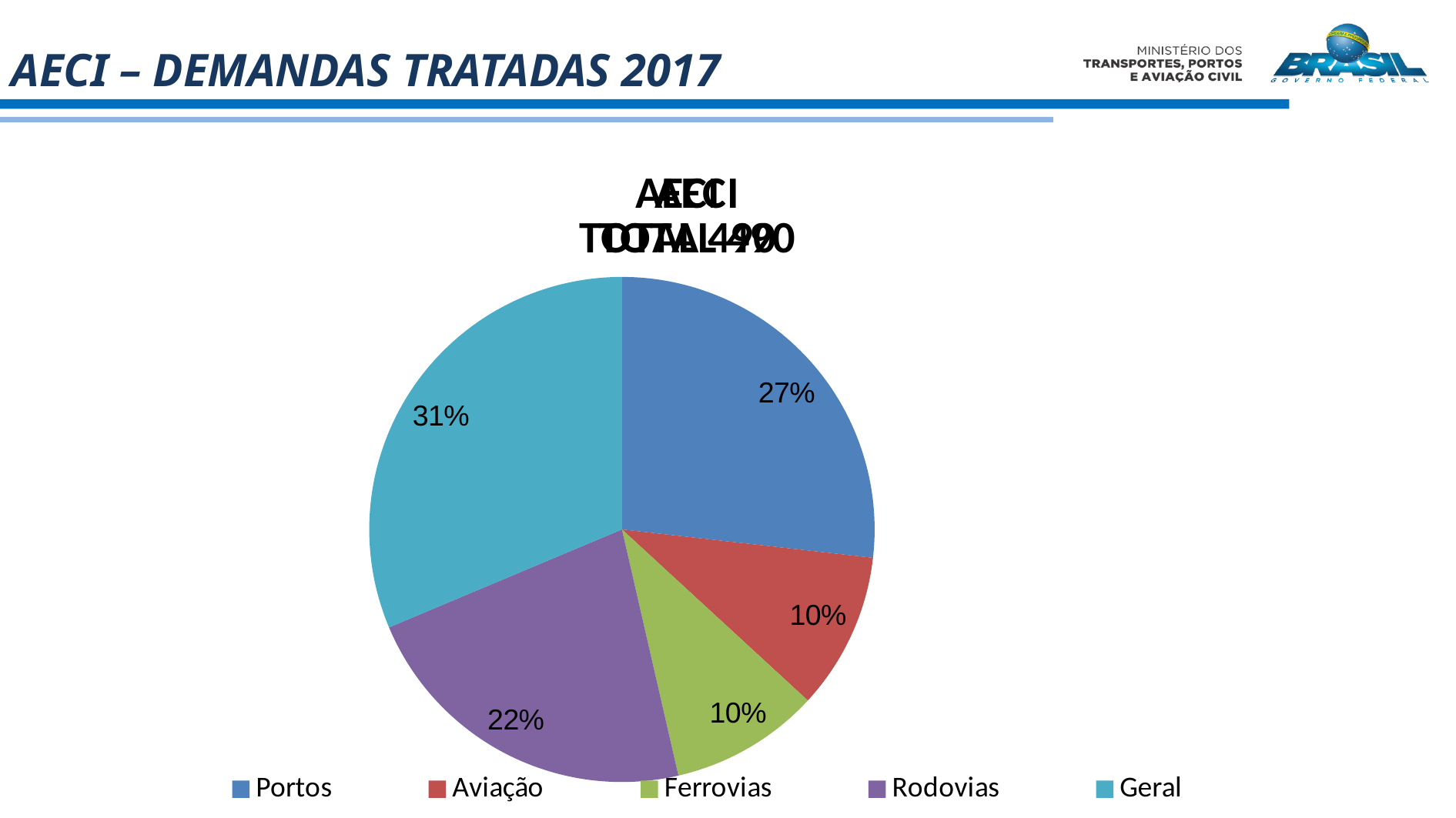
How many categories does the legend list? 5 What share of the pie does Ferrovias represent? 10% Which category has a larger share, Portos or Rodovias? Portos What share of the pie does Geral represent? 31% What share of the pie does Rodovias represent? 22% Which colour represents Rodovias in the pie chart? Purple What kind of chart is shown on the slide? Pie chart What is the difference in percentage points between the Rodovias and Aviação slices? 12% What is the difference in percentage points between the Geral and Portos slices? 4% Which category has the largest slice of the pie? Geral